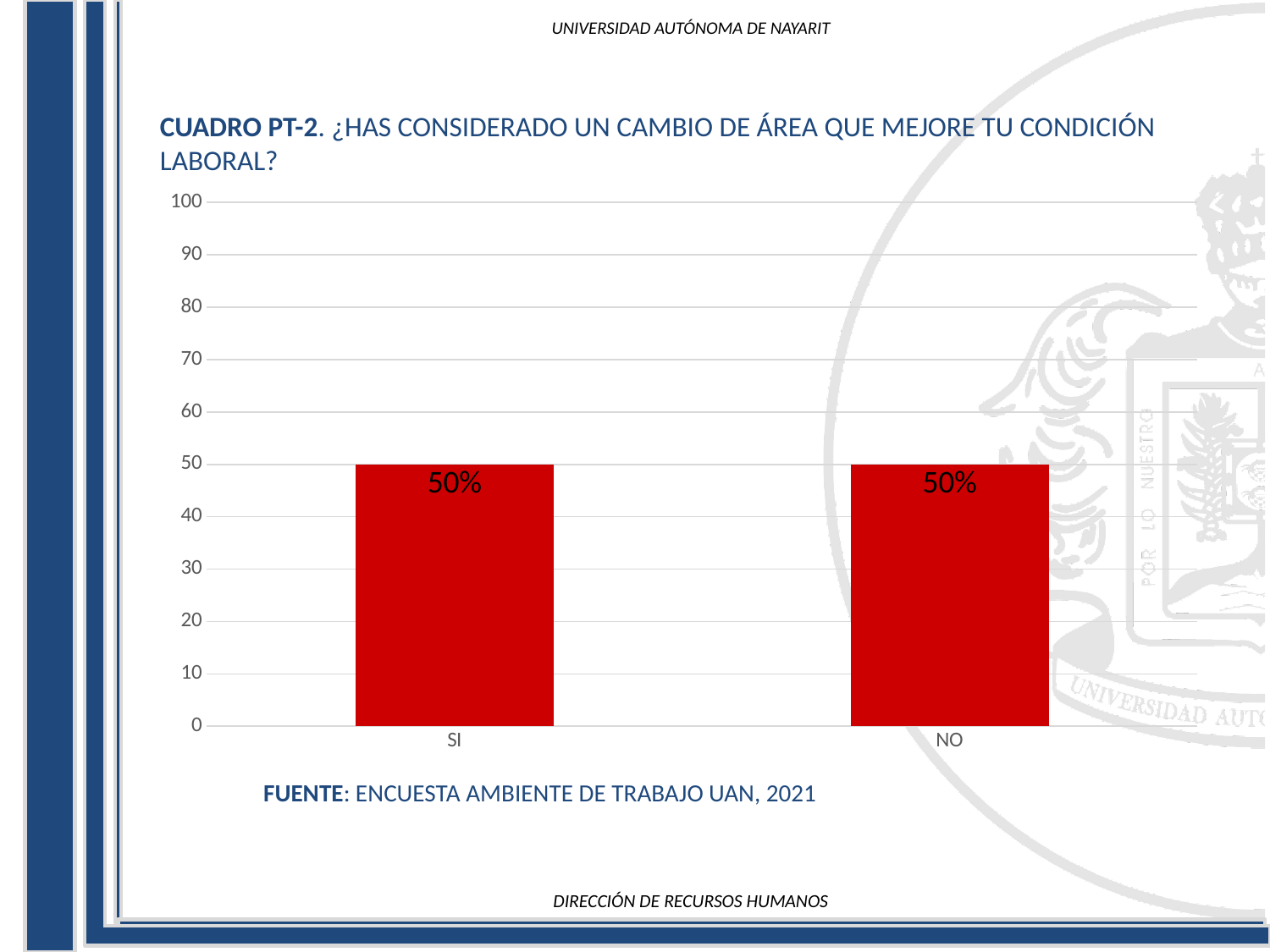
What is the highest value shown on the y axis? 100 What is the difference between the values for SI and NO? 0 How many categories are shown on the x axis? 2 What is the value for NO? 50% Do the values for SI and NO differ, or are they equal? equal What colour are the bars in the chart? red What is the value for SI? 50% Is the value for NO greater or less than 40? greater Is the value for SI greater or less than 60? less What kind of chart is shown on the slide? bar chart